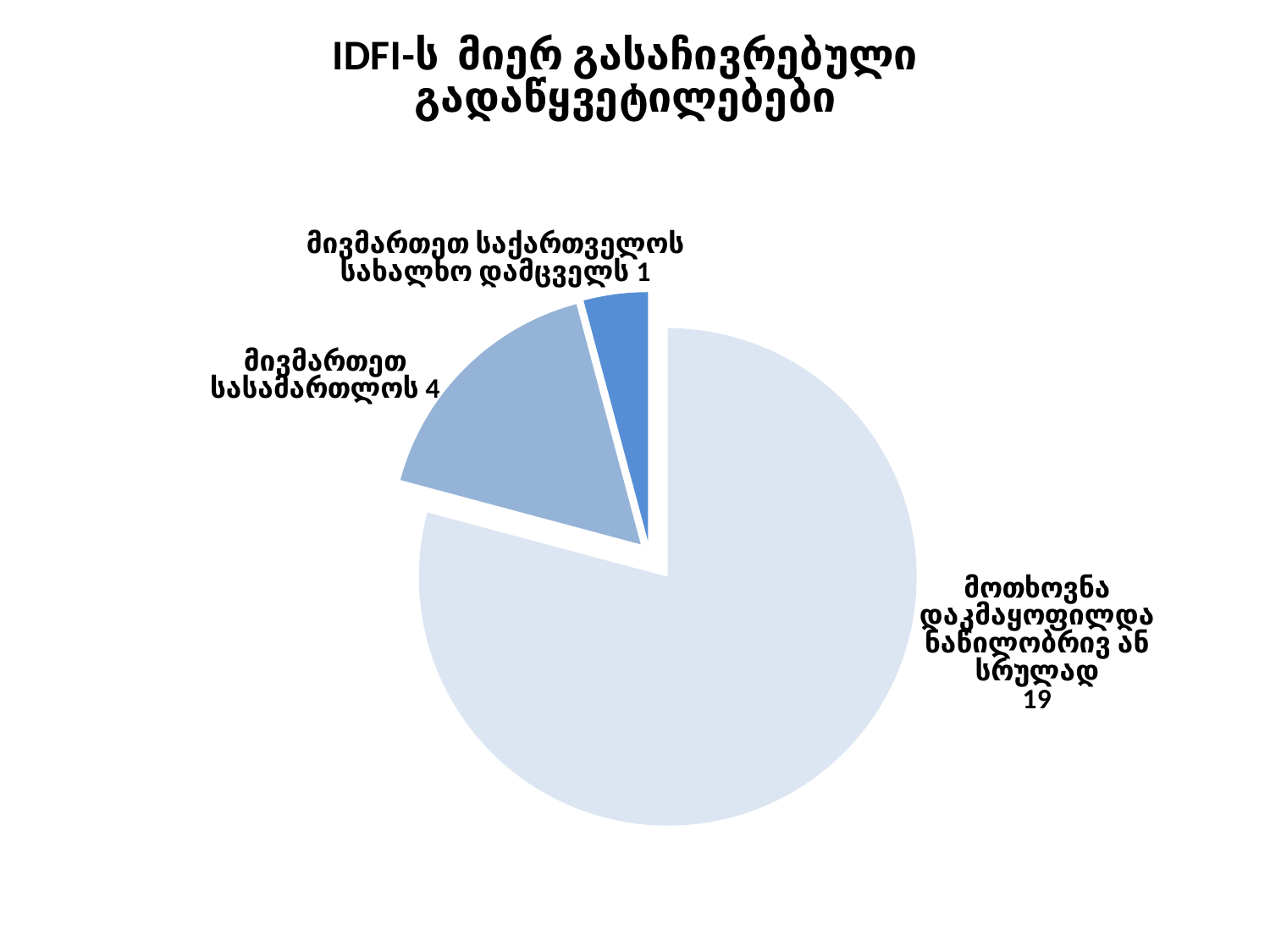
What is the value for the slice labelled "მივმართეთ საქართველოს სახალხო დამცველს"? 1 Which slice of the pie chart is the largest? მოთხოვნა დაკმაყოფილდა ნაწილობრივ ან სრულად What is the title of the chart? IDFI-ს მიერ გასაჩივრებული გადაწყვეტილებები How many slices does the pie chart have? 3 What share of the total does the slice "მოთხოვნა დაკმაყოფილდა ნაწილობრივ ან სრულად" represent? 19 out of 24 What kind of chart is shown on the slide? pie chart What is the difference between the value for "მოთხოვნა დაკმაყოფილდა ნაწილობრივ ან სრულად" and the value for "მივმართეთ სასამართლოს"? 15 Which is larger: the value for "მივმართეთ სასამართლოს" or the value for "მივმართეთ საქართველოს სახალხო დამცველს"? მივმართეთ სასამართლოს What is the value for the slice labelled "მივმართეთ სასამართლოს"? 4 Which slice of the pie chart is the smallest? მივმართეთ საქართველოს სახალხო დამცველს What is the total of all the values shown in the pie chart? 24 What is the value for the slice labelled "მოთხოვნა დაკმაყოფილდა ნაწილობრივ ან სრულად"? 19